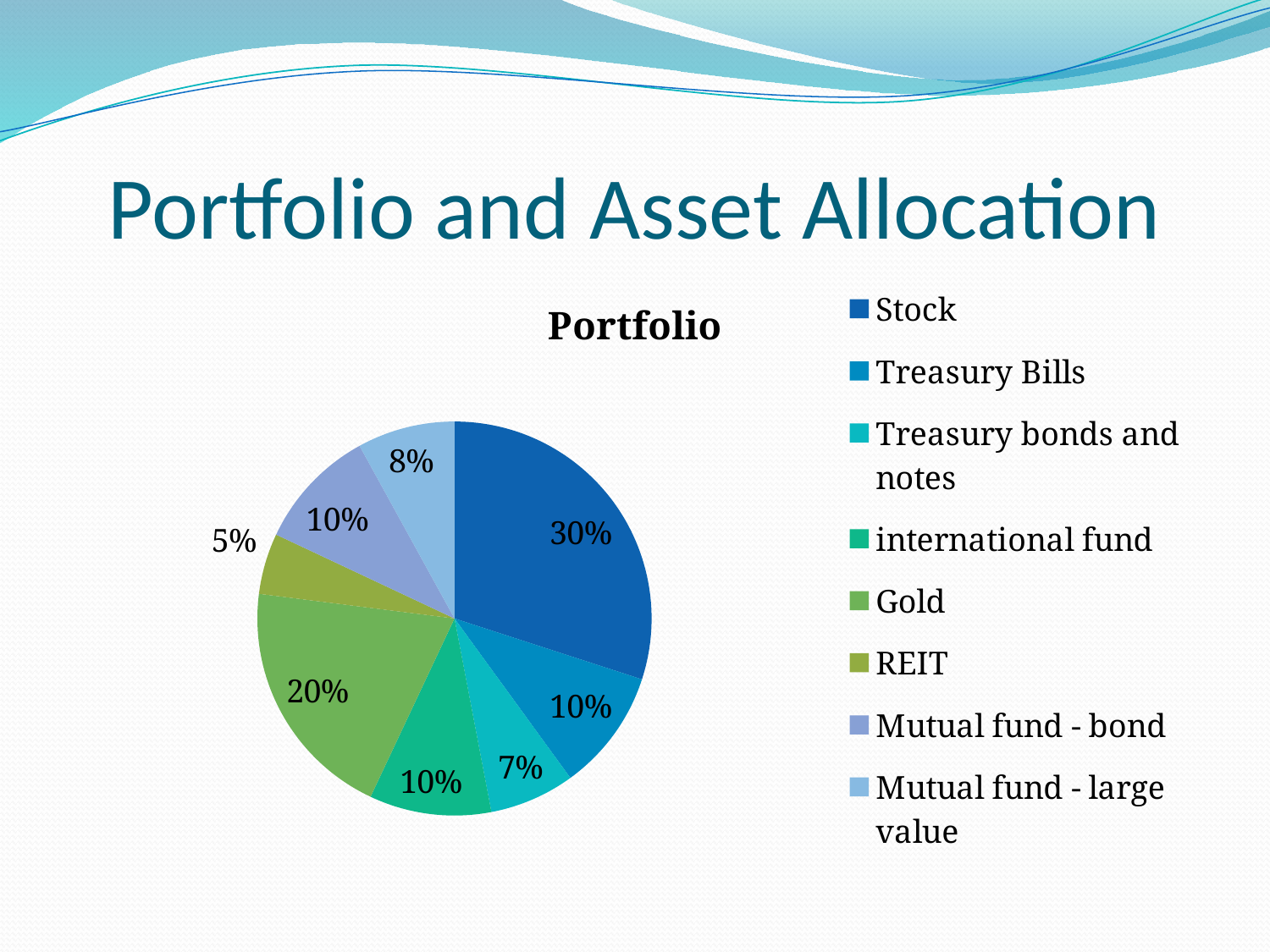
What is the title of the chart? Portfolio Which has a larger share of the portfolio, Treasury Bills or Treasury bonds and notes? Treasury Bills What share of the portfolio is allocated to Stock? 30% How many asset categories does the legend list? 8 What type of chart is shown on the slide? Pie chart What share of the portfolio is allocated to Treasury bonds and notes? 7% Which asset has the smallest share of the portfolio? REIT What share of the portfolio is allocated to Mutual fund - large value? 8% What is the difference in percentage points between the Stock share and the Gold share? 10 percentage points What share of the portfolio is allocated to REIT? 5% What share of the portfolio is allocated to Gold? 20% Which asset has the largest share of the portfolio? Stock